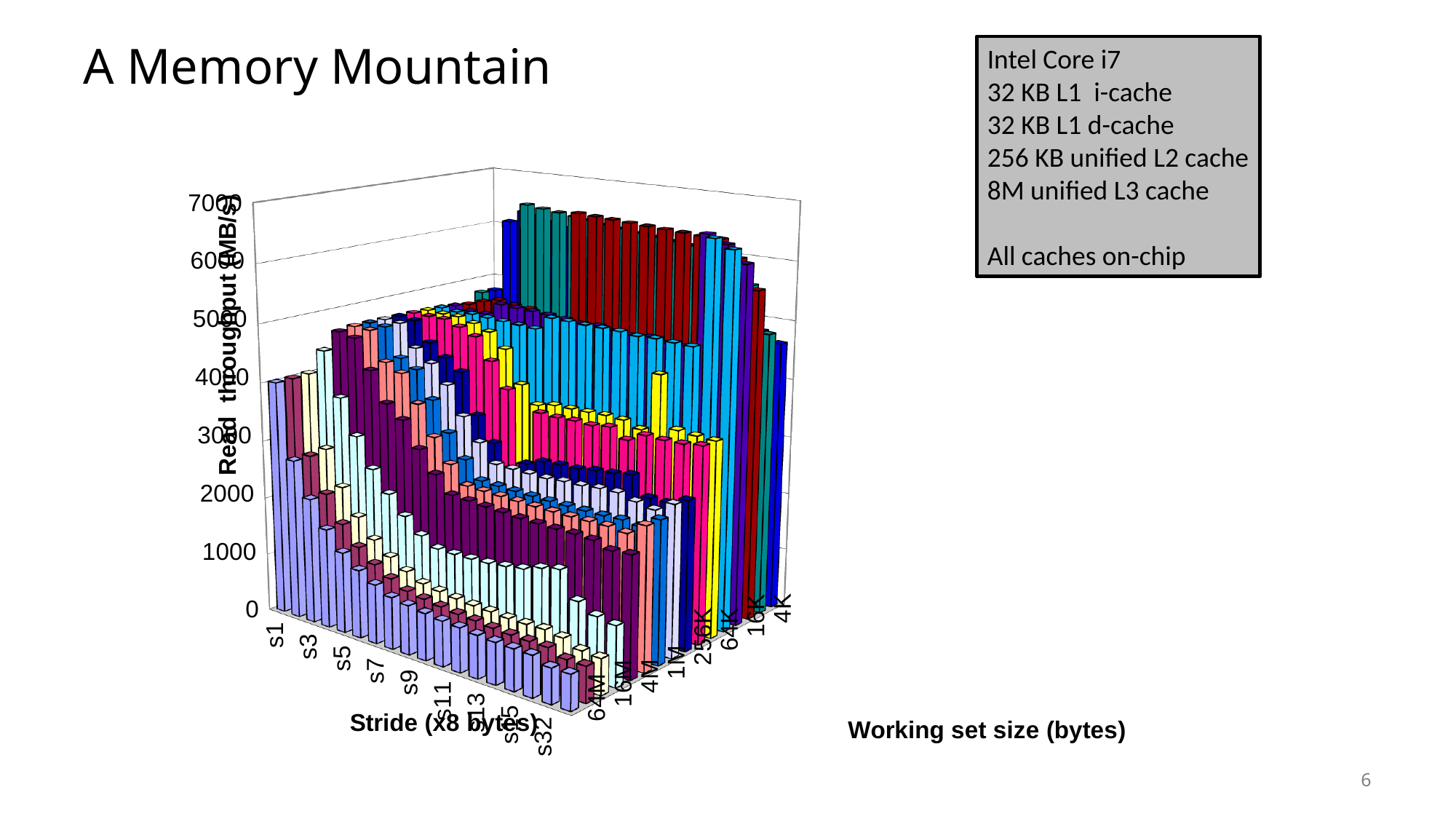
What is the lowest tick value shown on the vertical axis? 0 Is the read throughput for stride s32 at working set size 64M greater or less than 1000? less For the 64M working set, does read throughput rise or fall as the stride increases from s1 to s32? fall Which working set size label is at the far end of the depth axis, next to 16K? 4K What is the label of the vertical axis of the chart? Read throughput (MB/s) How many working set size labels are shown along the depth axis? 8 What is the highest tick value shown on the vertical axis? 7000 Which working set size label is at the front of the depth axis, nearest the stride axis? 64M What is the label of the axis showing s1, s3, s5 and so on? Stride (x8 bytes) What kind of chart is shown on the slide? bar chart Is the read throughput for stride s1 at working set size 4K greater or less than 6000? less Is the read throughput for stride s1 at working set size 64M greater or less than 3000? greater